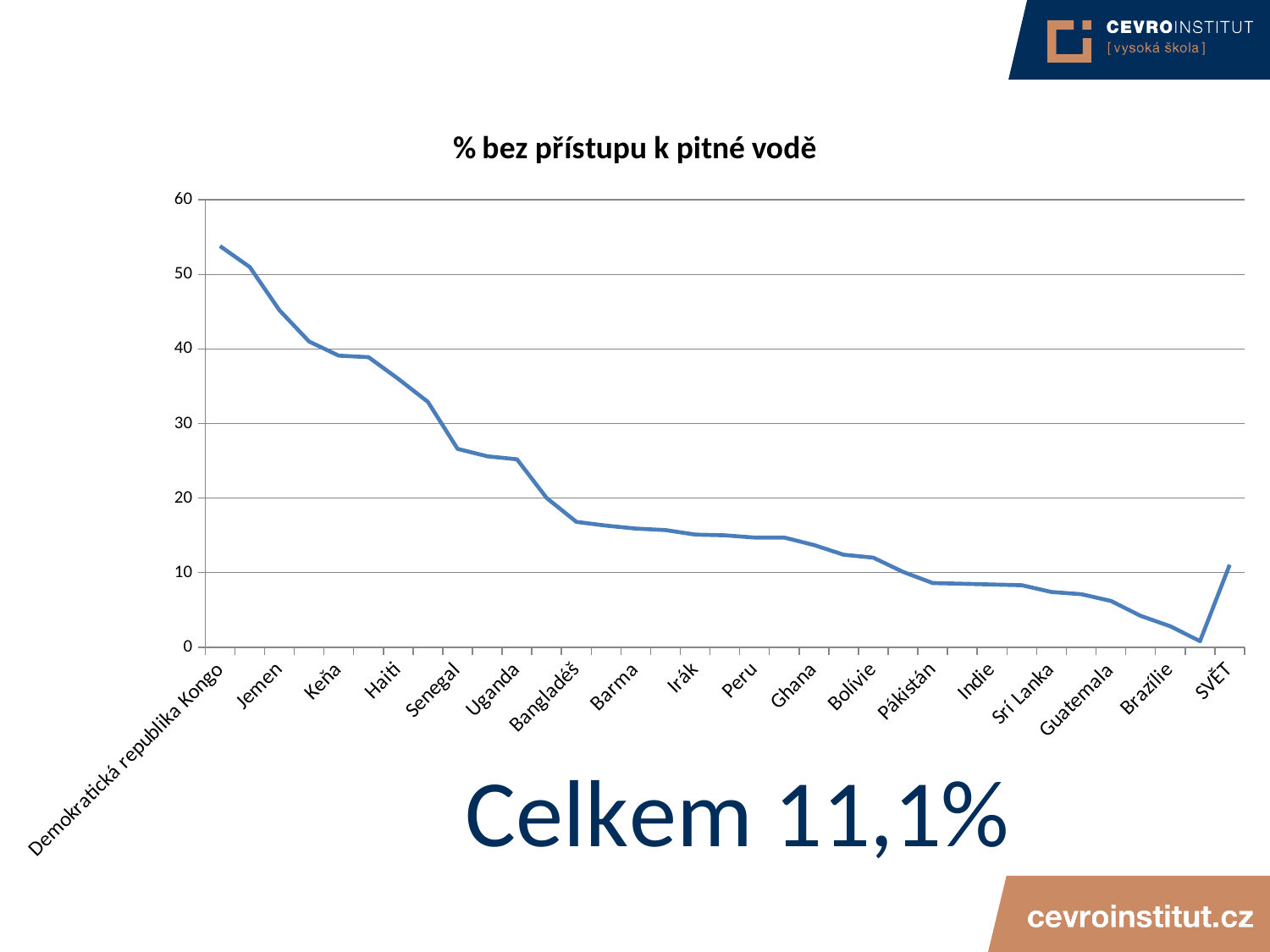
Which has a larger value, SVĚT or Brazílie? SVĚT Is the value for Guatemala greater or less than 10? less Is the value for Demokratická republika Kongo greater or less than 50? greater Which has a larger value, Jemen or Indie? Jemen What is the title of the chart? % bez přístupu k pitné vodě Is the value for Uganda greater or less than 30? less Do the values generally rise or fall from Demokratická republika Kongo to Brazílie along the x axis? fall Which labeled category has the highest value in the chart? Demokratická republika Kongo What kind of chart is shown on the slide? line chart